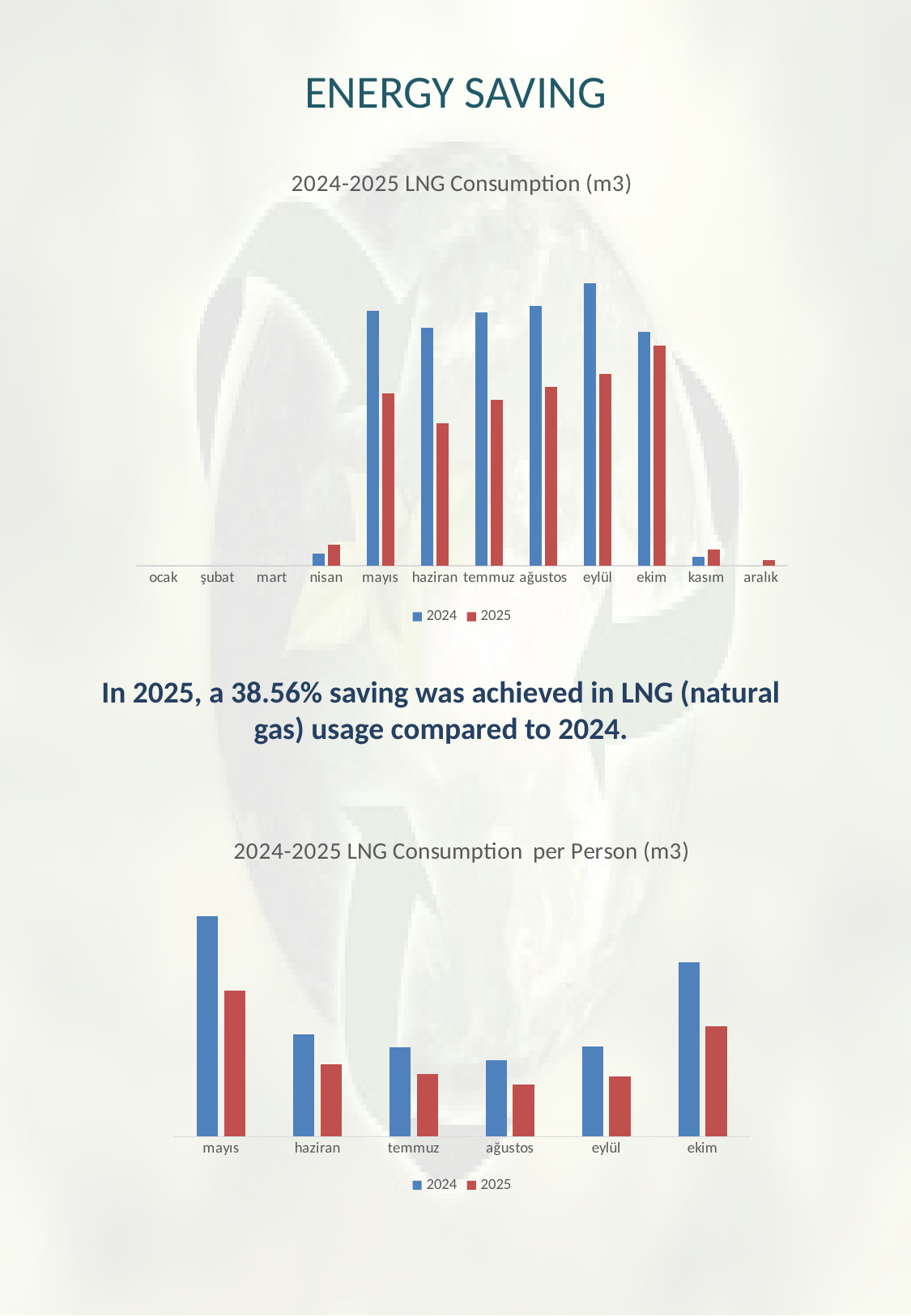
How many months are shown on the x axis of the '2024-2025 LNG Consumption per Person (m3)' chart? 6 How many series does the legend of the '2024-2025 LNG Consumption (m3)' chart list? 2 In the '2024-2025 LNG Consumption per Person (m3)' chart, which colour represents the 2025 series? Red In the '2024-2025 LNG Consumption per Person (m3)' chart, which month has the highest 2024 value? mayıs In the '2024-2025 LNG Consumption (m3)' chart, which is larger: the 2024 value for eylül or the 2024 value for ekim? eylül In the '2024-2025 LNG Consumption per Person (m3)' chart, which is larger: the 2025 value for haziran or the 2025 value for ekim? ekim In the '2024-2025 LNG Consumption (m3)' chart, is the 2024 value or the 2025 value larger for mayıs? 2024 In the '2024-2025 LNG Consumption (m3)' chart, which month has the tallest 2025 bar? ekim In the '2024-2025 LNG Consumption per Person (m3)' chart, do the 2024 values rise or fall from mayıs to ağustos? Fall What type of chart is the '2024-2025 LNG Consumption (m3)' chart? Bar chart In the '2024-2025 LNG Consumption (m3)' chart, which month has the tallest 2024 bar? eylül How many months are shown on the x axis of the '2024-2025 LNG Consumption (m3)' chart? 12